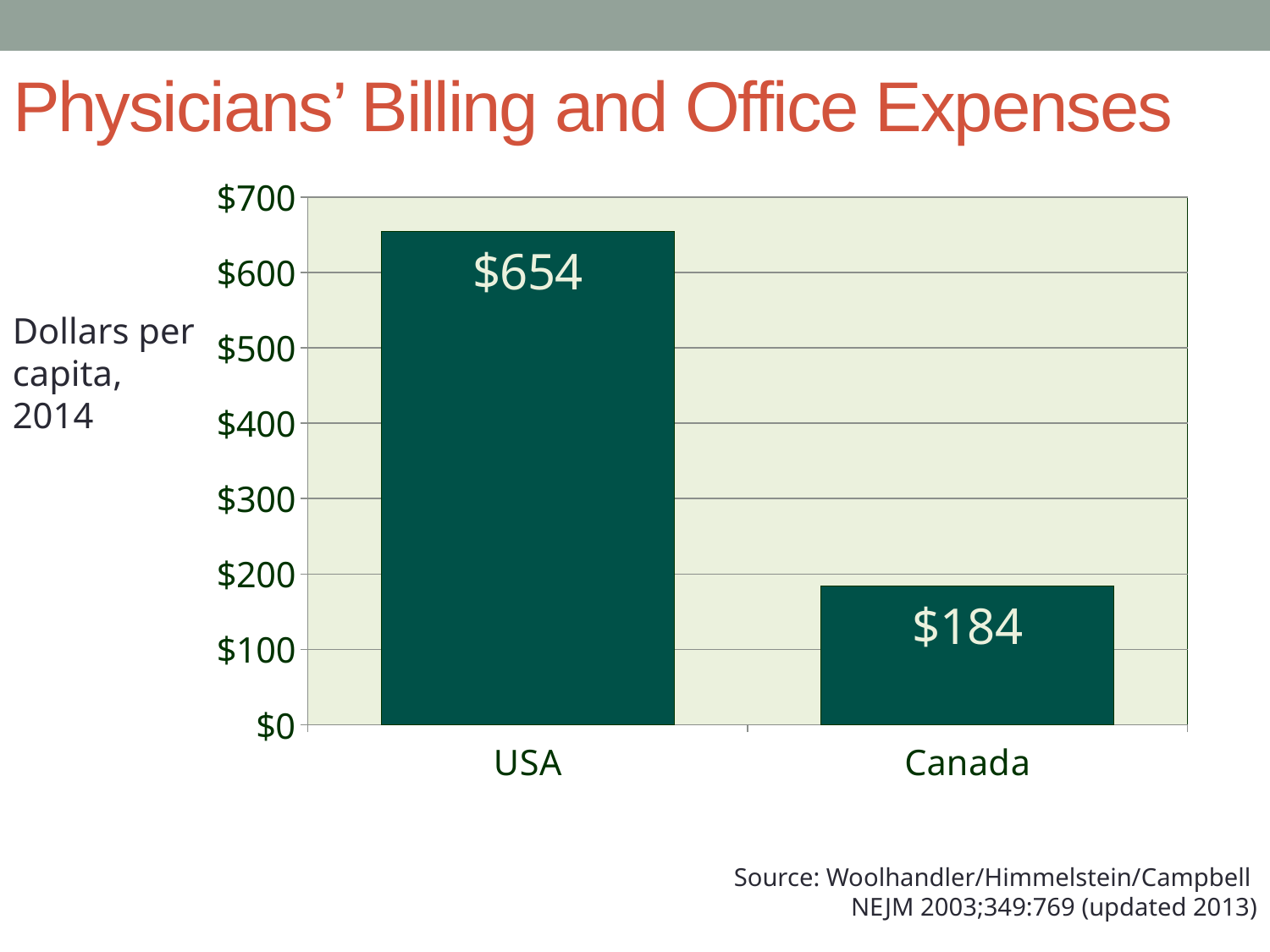
Which country has the highest physicians' billing and office expenses per capita? USA Is the value for Canada greater or less than $200? less What kind of chart is shown on the slide? bar chart What unit is the y axis measured in, according to the label on the slide? Dollars per capita, 2014 Which is larger, the value for USA or the value for Canada? USA What is the title of the slide? Physicians' Billing and Office Expenses Is the value for USA greater or less than $600? greater What is the difference between the USA and Canada values? $470 How many countries are shown in the chart? 2 What is the value for USA? $654 What is the value for Canada? $184 Which country has the lowest physicians' billing and office expenses per capita? Canada